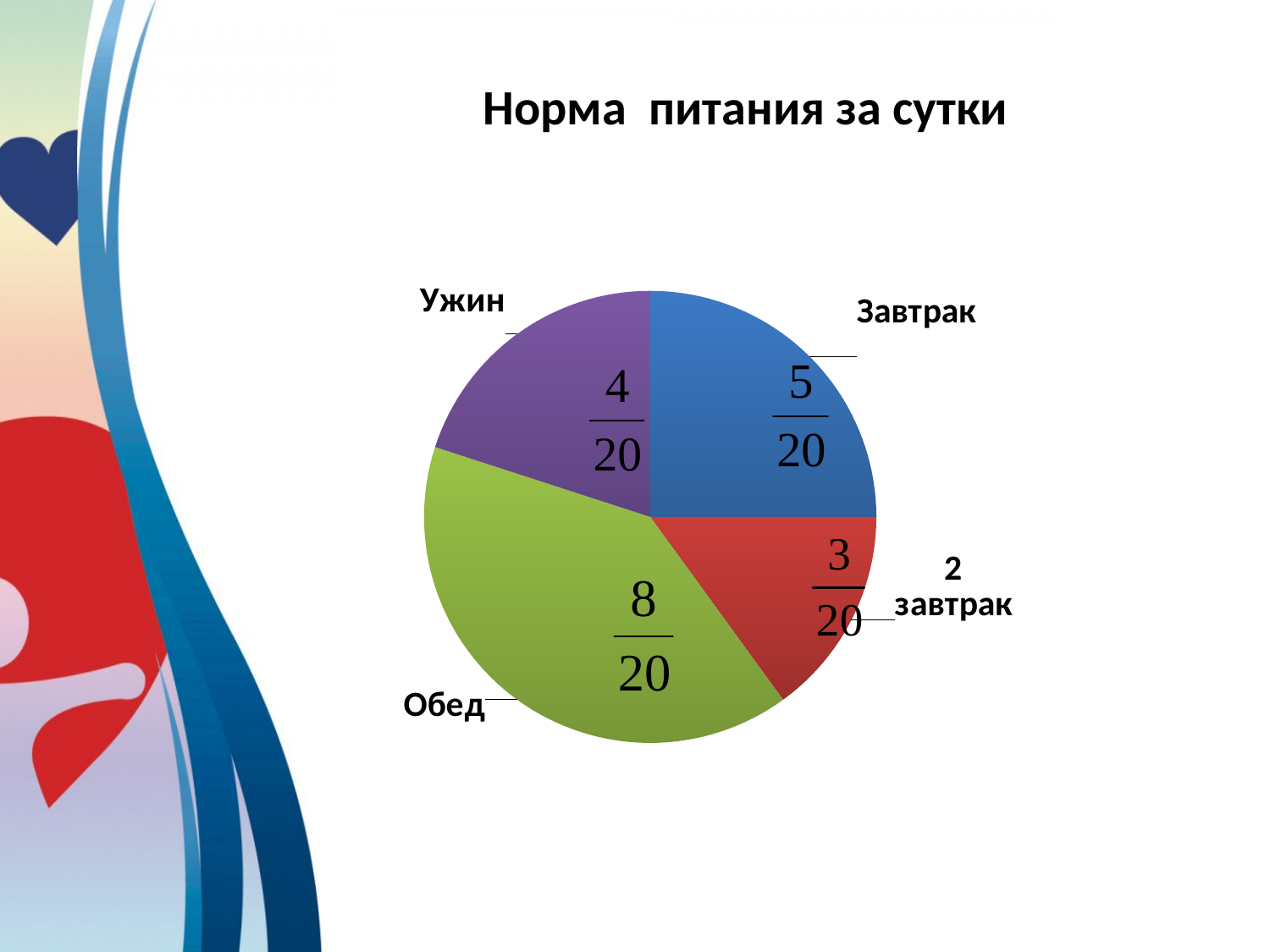
Which is larger, the slice for Завтрак or the slice for Ужин? Завтрак What is the difference between the values for Обед and Ужин? 4/20 What value is shown for Ужин? 4/20 What colour is the slice for Обед? green Which slice of the pie is the smallest? 2 завтрак What is the title of the chart? Норма питания за сутки What value is shown for Обед? 8/20 How many slices does the pie chart have? 4 Which slice of the pie is the largest? Обед What value is shown for Завтрак? 5/20 What kind of chart is shown on the slide? pie chart What value is shown for 2 завтрак? 3/20